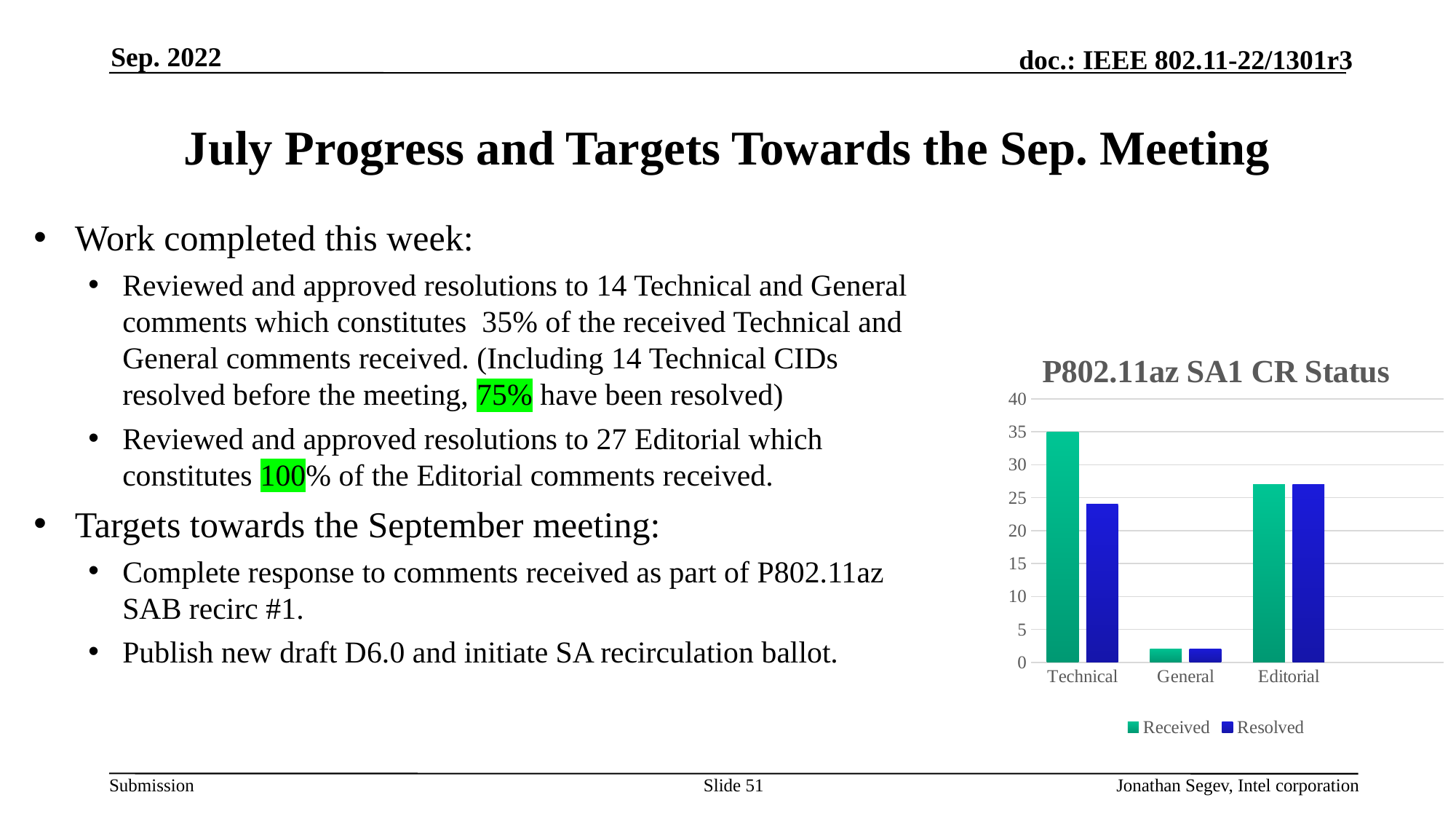
Which series is shown in dark blue in the chart legend? Resolved How many series does the chart legend list? 2 What is the title of the chart? P802.11az SA1 CR Status What kind of chart is shown on the slide? bar chart Is the Received value for Editorial greater or less than 25? greater Is the Resolved value for Technical greater or less than 20? greater For Technical, which is larger: Received or Resolved? Received How many categories are shown on the x axis of the chart? 3 Which category has the highest Received value? Technical What is the Received value for Technical? 35 Is the Received value for General greater or less than 5? less Which category has the lowest Resolved value? General